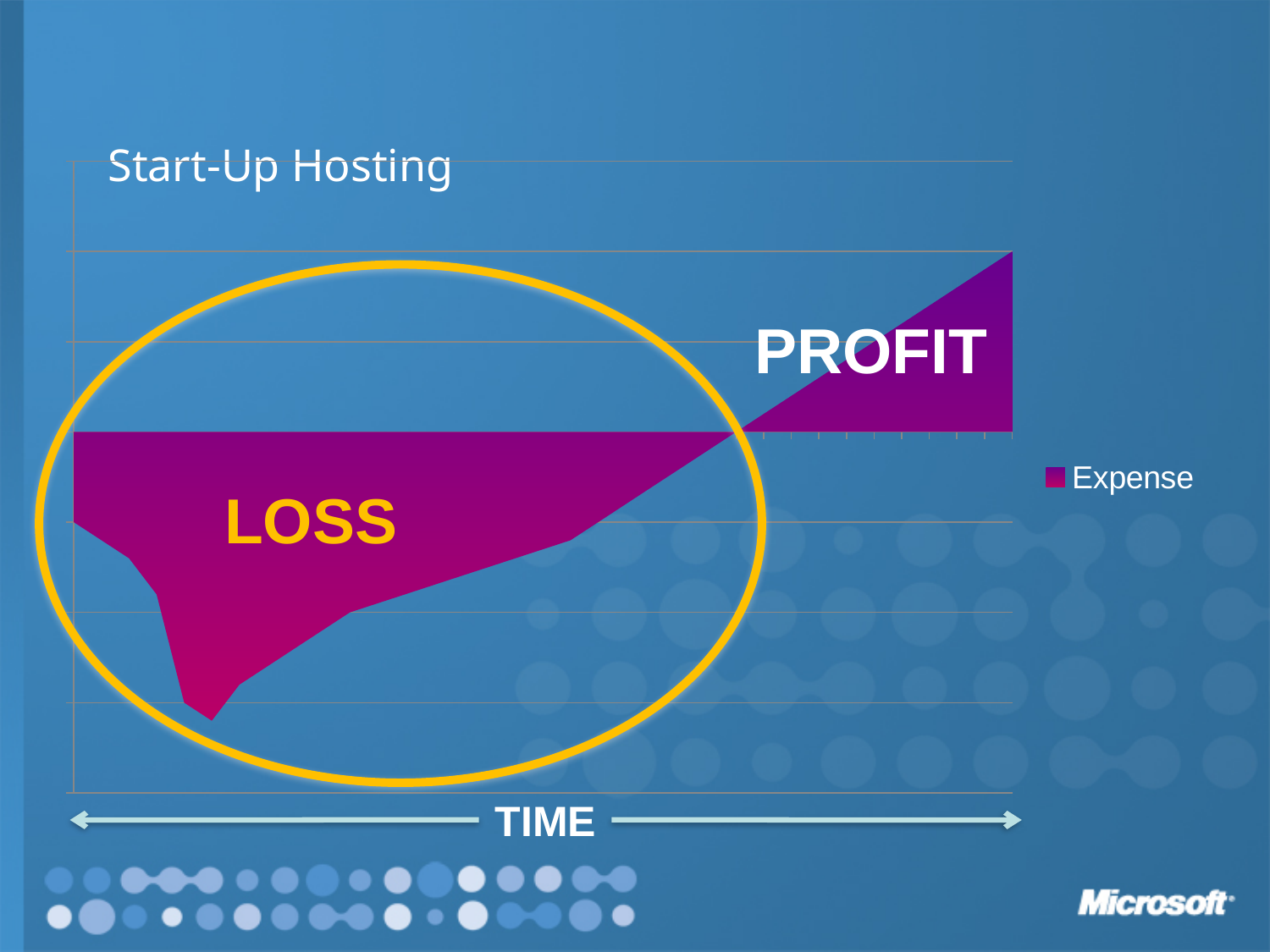
What is the name of the series listed in the legend? Expense What is the title of the chart? Start-Up Hosting Do the plotted values rise or fall overall from left to right along the x axis? rise How many series does the legend list? 1 What kind of chart is shown on the slide? area chart